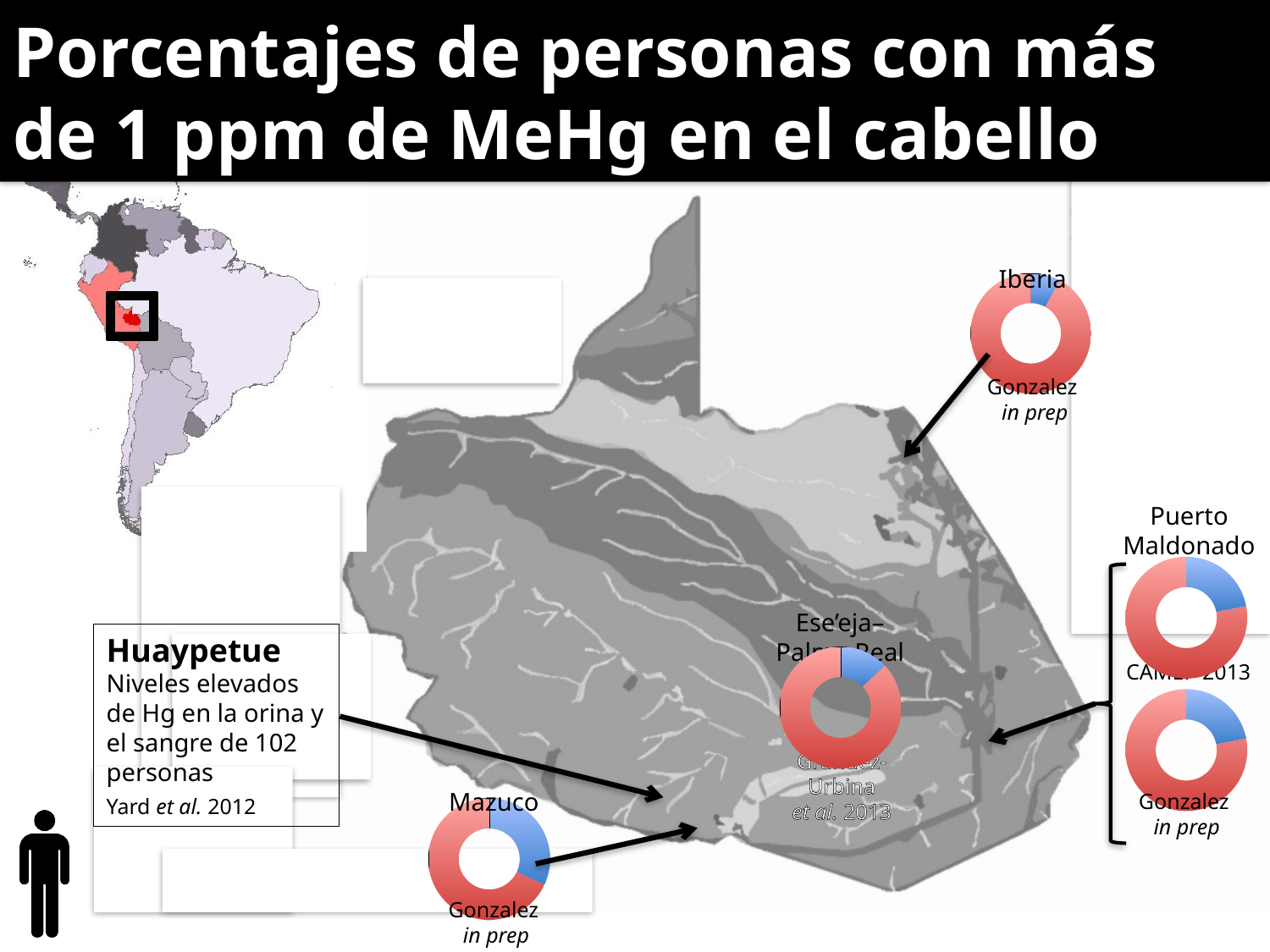
Which location's donut chart has the smallest blue segment? Iberia How many segments does the Mazuco donut chart have? 2 What kind of chart is used for the Iberia data on the slide? Donut chart Which source is cited below the Mazuco donut chart? Gonzalez in prep Is the blue segment larger in the Ese'eja–Palma Real donut chart or in the Mazuco donut chart? Mazuco In the Iberia donut chart, which colour occupies the larger share, red or blue? Red Which location's donut chart has the largest blue segment? Mazuco Is the blue segment larger in the Mazuco donut chart or in the Iberia donut chart? Mazuco What is the title of the slide? Porcentajes de personas con más de 1 ppm de MeHg en el cabello How many donut charts are shown for Puerto Maldonado? 2 How many donut charts are shown on the slide? 5